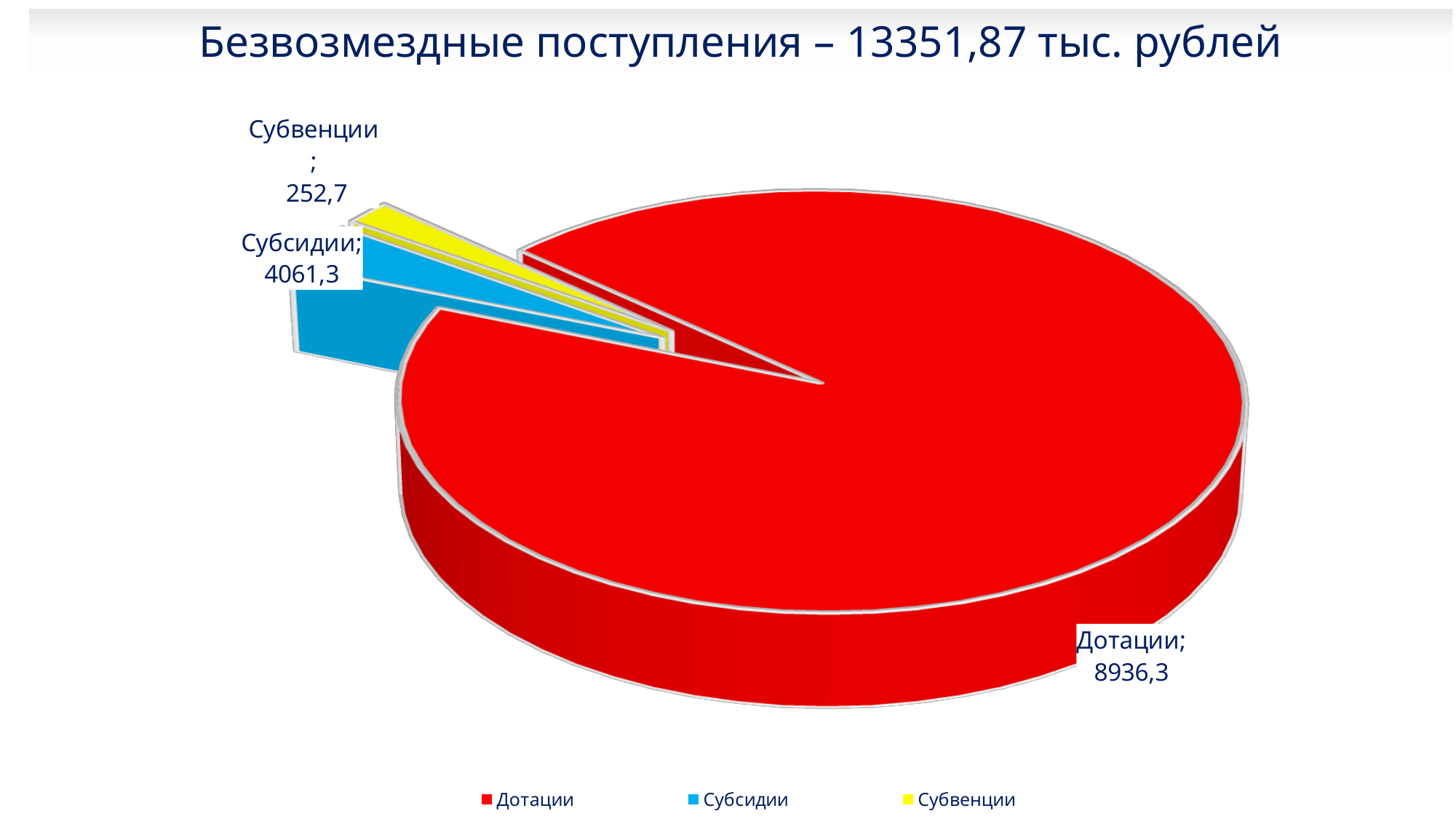
What is the value for Субвенции? 252,7 What colour is the slice for Субвенции? Yellow What is the value for Дотации? 8936,3 What type of chart is shown on the slide? Pie chart Which category has the smallest slice of the pie? Субвенции What is the value for Субсидии? 4061,3 How many slices does the pie chart have? 3 Which is larger, the value for Субсидии or the value for Субвенции? Субсидии Which category has the largest slice of the pie? Дотации How many entries does the legend list? 3 What is the difference between the values for Дотации and Субсидии? 4875,0 What is the difference between the values for Субсидии and Субвенции? 3808,6